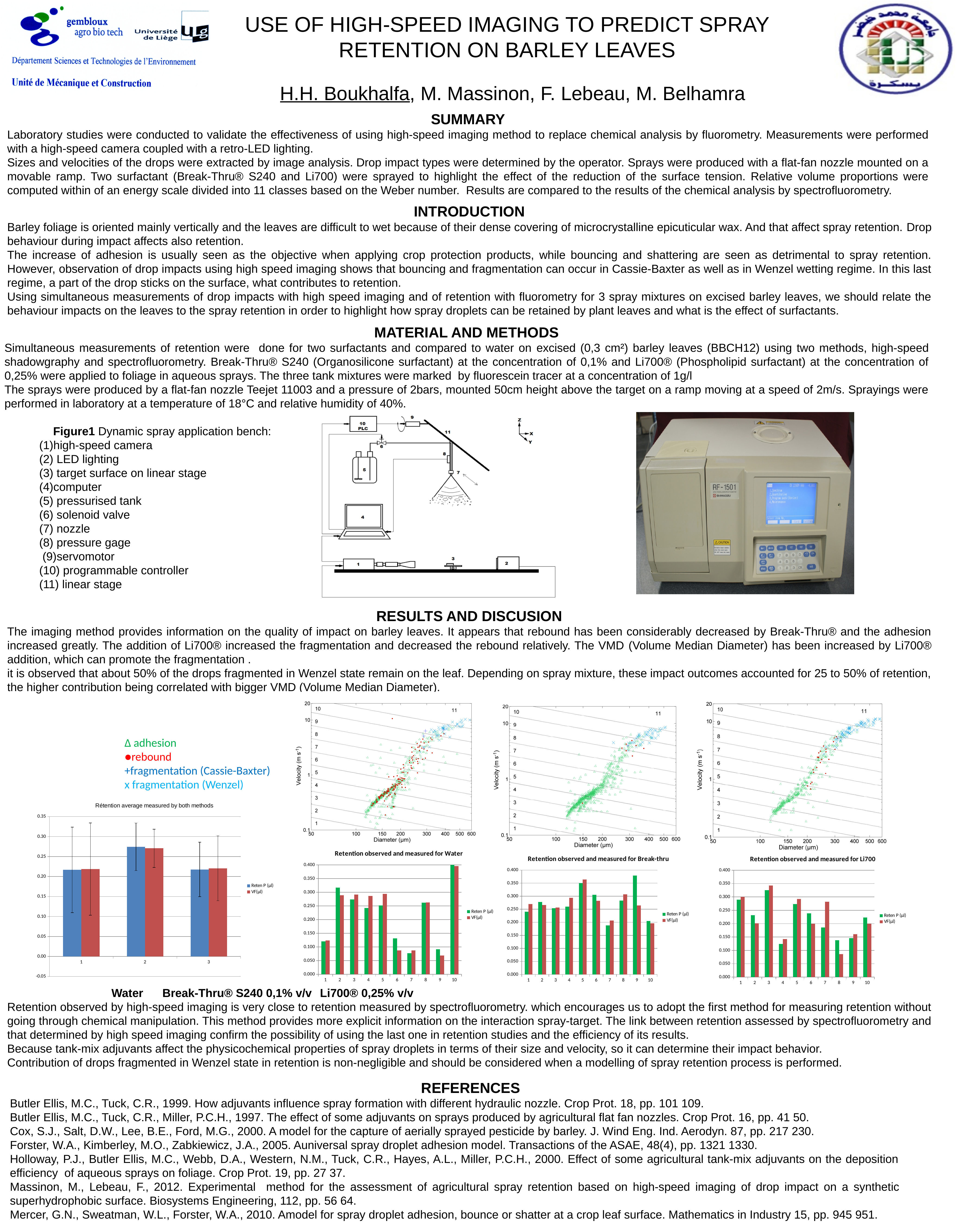
In the 'Retention observed and measured for Li700' chart, is the VF(µl) value for category 3 greater or less than 0.300? greater In the 'Retention observed and measured for Water' chart, which category has the highest Reten P (µl) value? 10 How many categories are shown on the x axis of the 'Retention observed and measured for Water' chart? 10 In the 'Rétention average measured by both methods' chart, is the Reten P (µl) value for category 2 greater or less than 0.25? greater How many categories are shown on the x axis of the 'Rétention average measured by both methods' chart? 3 What kind of chart is the 'Rétention average measured by both methods' chart? bar chart In the 'Retention observed and measured for Break-thru' chart, which category has the highest Reten P (µl) value? 9 In the 'Rétention average measured by both methods' chart, which category has the highest Reten P (µl) value? 2 In the 'Retention observed and measured for Li700' chart, which category has the lowest VF(µl) value? 8 How many series does the legend of the 'Rétention average measured by both methods' chart list? 2 What is the y-axis label of the three scatter plots in the results section? Velocity (m s-1) In the 'Retention observed and measured for Water' chart, is the Reten P (µl) value for category 6 greater or less than 0.150? less